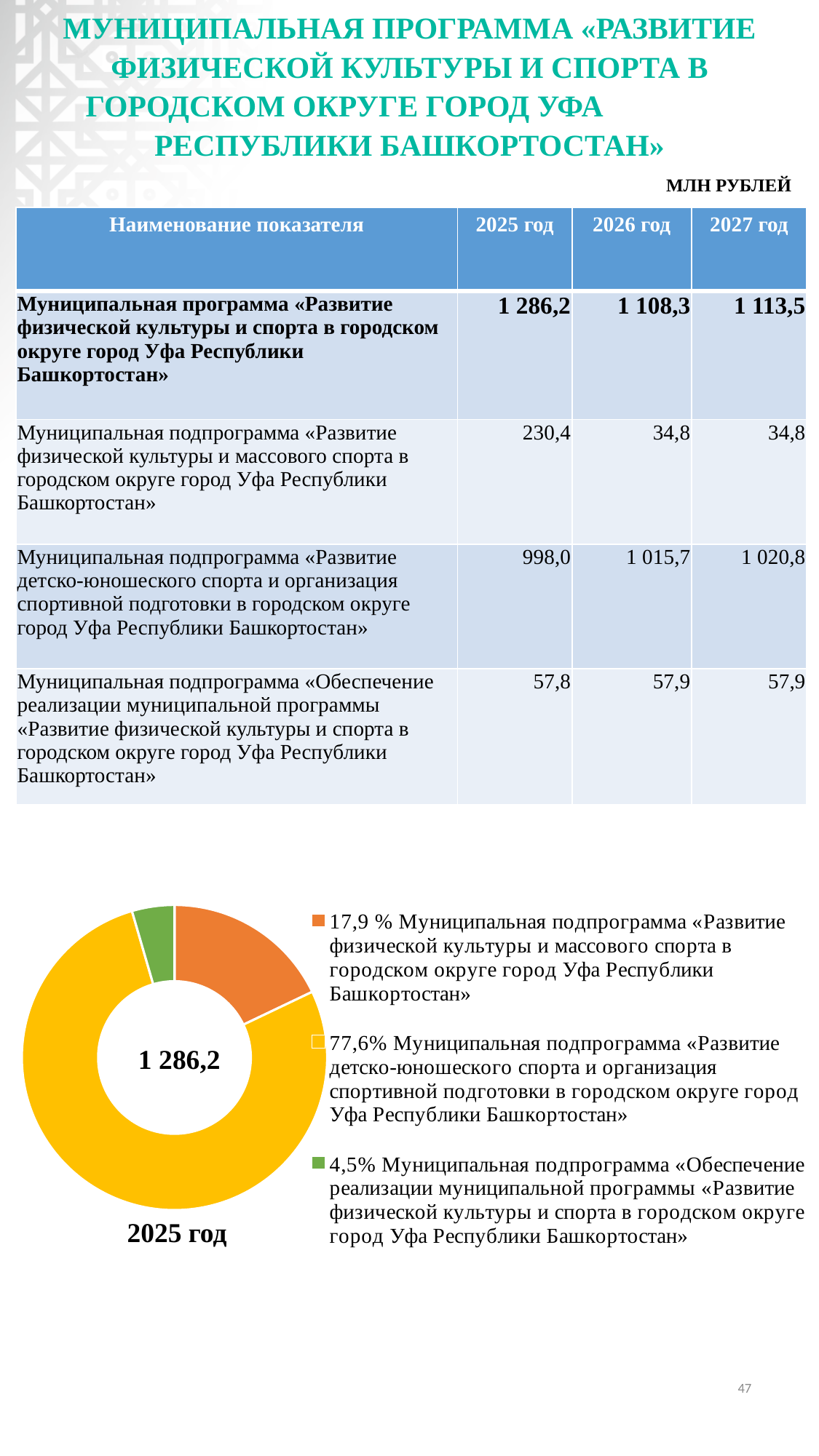
What share of the doughnut chart does the subprogramme «Обеспечение реализации муниципальной программы «Развитие физической культуры и спорта в городском округе город Уфа Республики Башкортостан» take? 4,5% What share of the doughnut chart does the subprogramme «Развитие детско-юношеского спорта и организация спортивной подготовки в городском округе город Уфа Республики Башкортостан» take? 77,6% What value is printed in the centre of the doughnut chart? 1 286,2 By how many percentage points does the 77,6% slice exceed the 17,9 % slice in the doughnut chart? 59,7 How many slices does the doughnut chart have? 3 What kind of chart is shown at the bottom of the slide? Doughnut (pie) chart What share of the doughnut chart does the subprogramme «Развитие физической культуры и массового спорта в городском округе город Уфа Республики Башкортостан» take? 17,9 % Which year does the doughnut chart represent, according to the label beneath it? 2025 год What colour is the slice for the subprogramme «Обеспечение реализации муниципальной программы» in the doughnut chart? Green In the doughnut chart, which slice is larger: the one for «Развитие физической культуры и массового спорта» or the one for «Обеспечение реализации муниципальной программы»? «Развитие физической культуры и массового спорта» Which subprogramme has the largest slice in the doughnut chart? Муниципальная подпрограмма «Развитие детско-юношеского спорта и организация спортивной подготовки в городском округе город Уфа Республики Башкортостан» Which subprogramme has the smallest slice in the doughnut chart? Муниципальная подпрограмма «Обеспечение реализации муниципальной программы «Развитие физической культуры и спорта в городском округе город Уфа Республики Башкортостан»